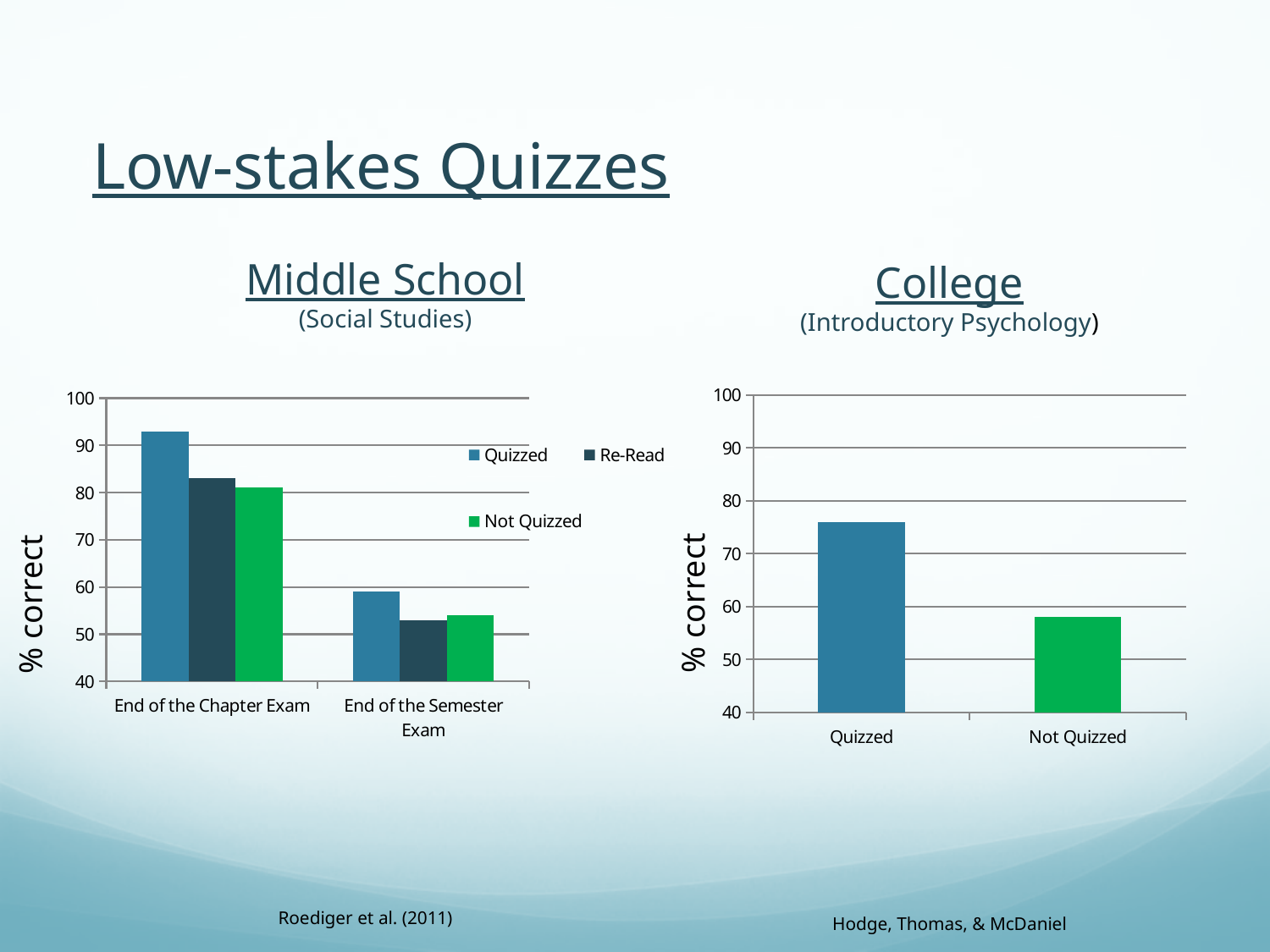
How many exam categories are shown on the x axis of the Middle School chart? 2 In the Middle School chart, which series has the highest value for the End of the Semester Exam? Quizzed In the Middle School chart, do the Quizzed values rise or fall from the End of the Chapter Exam to the End of the Semester Exam? fall In the Middle School chart, is the Quizzed value for the End of the Chapter Exam greater or less than 90? greater In the College chart, is the value for Quizzed greater or less than 70? greater In the College (Introductory Psychology) chart, which category has the higher value, Quizzed or Not Quizzed? Quizzed In the Middle School chart, which series has the highest value for the End of the Chapter Exam? Quizzed In the College chart, is the value for Not Quizzed greater or less than 50? greater How many series does the legend of the Middle School chart list? 3 What kind of chart is the Middle School (Social Studies) chart? bar chart What is the y-axis label of the College chart? % correct